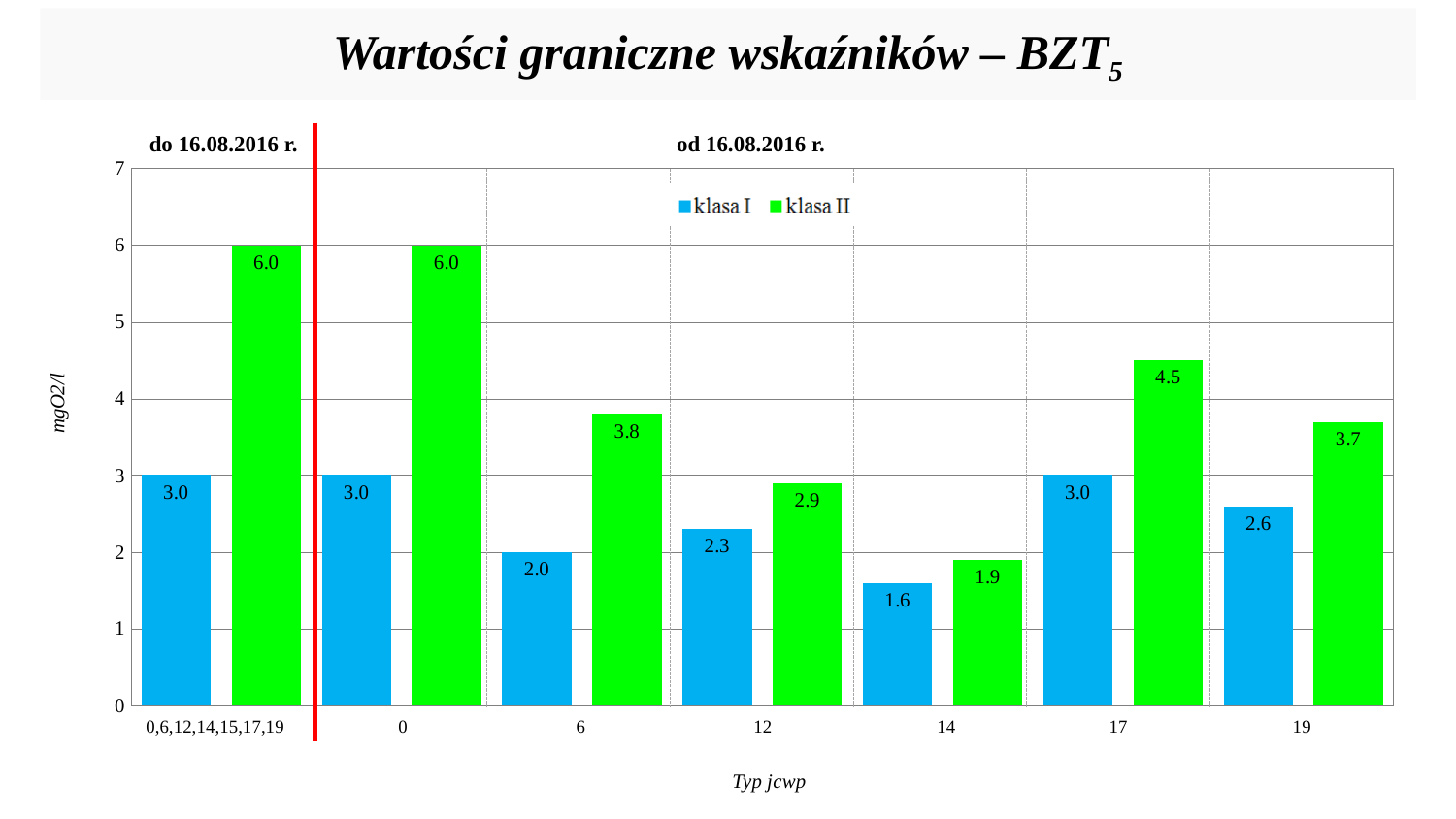
Among the categories after 16.08.2016 (od 16.08.2016 r.), which Typ jcwp has the highest klasa II value? 0 What is the difference between the klasa II and klasa I values for Typ jcwp 12? 0.6 What is the klasa II value for Typ jcwp 6? 3.8 How many series does the legend list? 2 What kind of chart is shown on the slide? Bar chart Which Typ jcwp category has the lowest klasa I value? 14 What is the klasa I value for Typ jcwp 14? 1.6 What is the klasa II value for Typ jcwp 17? 4.5 What is the klasa I value for Typ jcwp 19? 2.6 Which is larger: the klasa II value for Typ jcwp 19 or the klasa II value for Typ jcwp 17? Typ jcwp 17 How many Typ jcwp categories are shown on the x axis? 7 What is the label of the y axis? mgO2/l